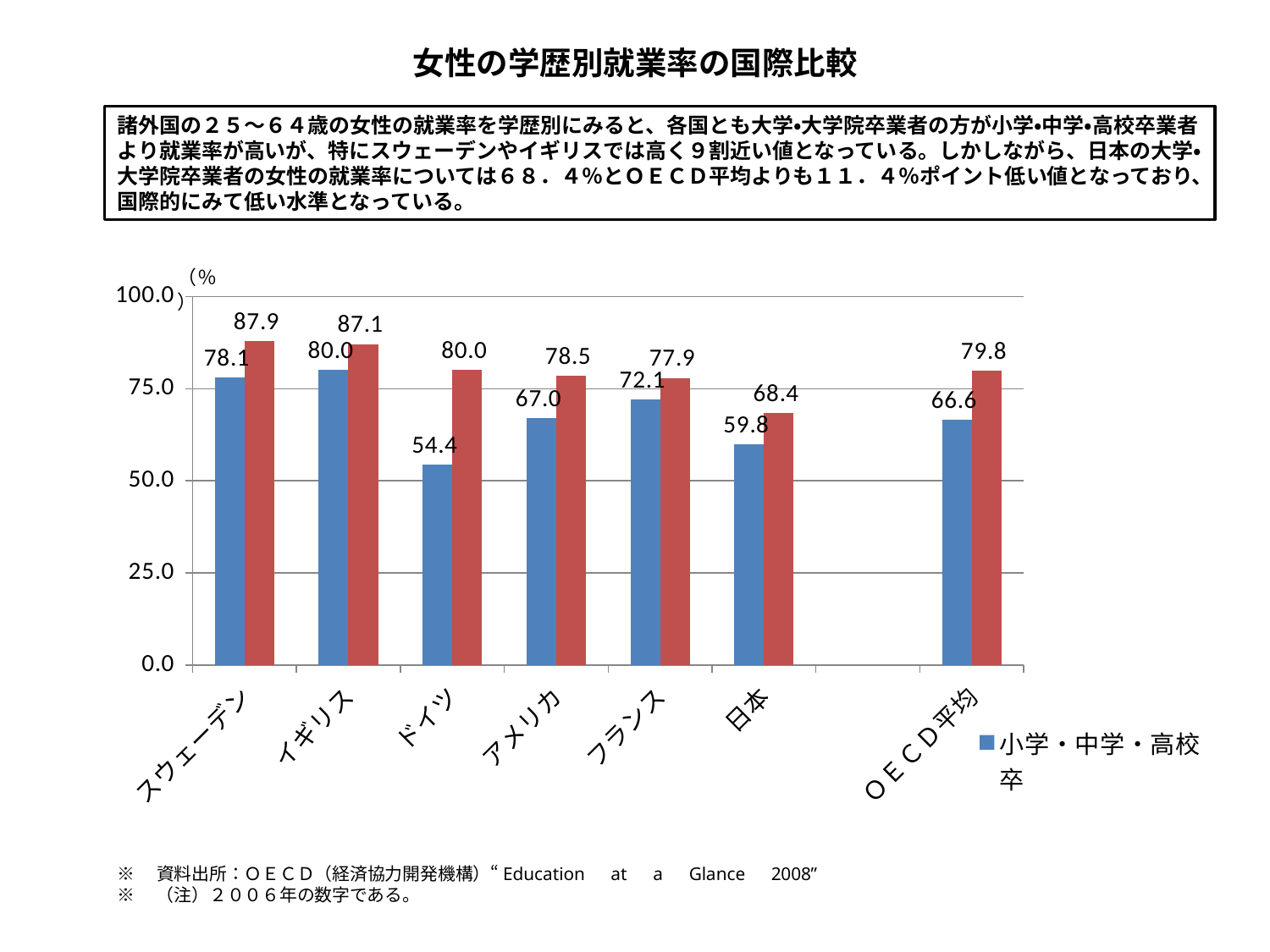
What is the value of the red bar for ＯＥＣＤ平均? 79.8 What is the value of the red bar for スウェーデン? 87.9 What is the value for 小学・中学・高校卒 in ドイツ? 54.4 What type of chart is shown on the slide? bar chart What is the value for 小学・中学・高校卒 in 日本? 59.8 What is the title of the chart on the slide? 女性の学歴別就業率の国際比較 Which category has the lowest red bar? 日本 Which category has the lowest value for 小学・中学・高校卒? ドイツ What is the difference between the red bar and the blue bar for 日本? 8.6 Which is larger: the 小学・中学・高校卒 value for アメリカ or for フランス? フランス How many countries/categories are shown on the x axis of the chart? 7 Which category has the highest value for 小学・中学・高校卒? イギリス